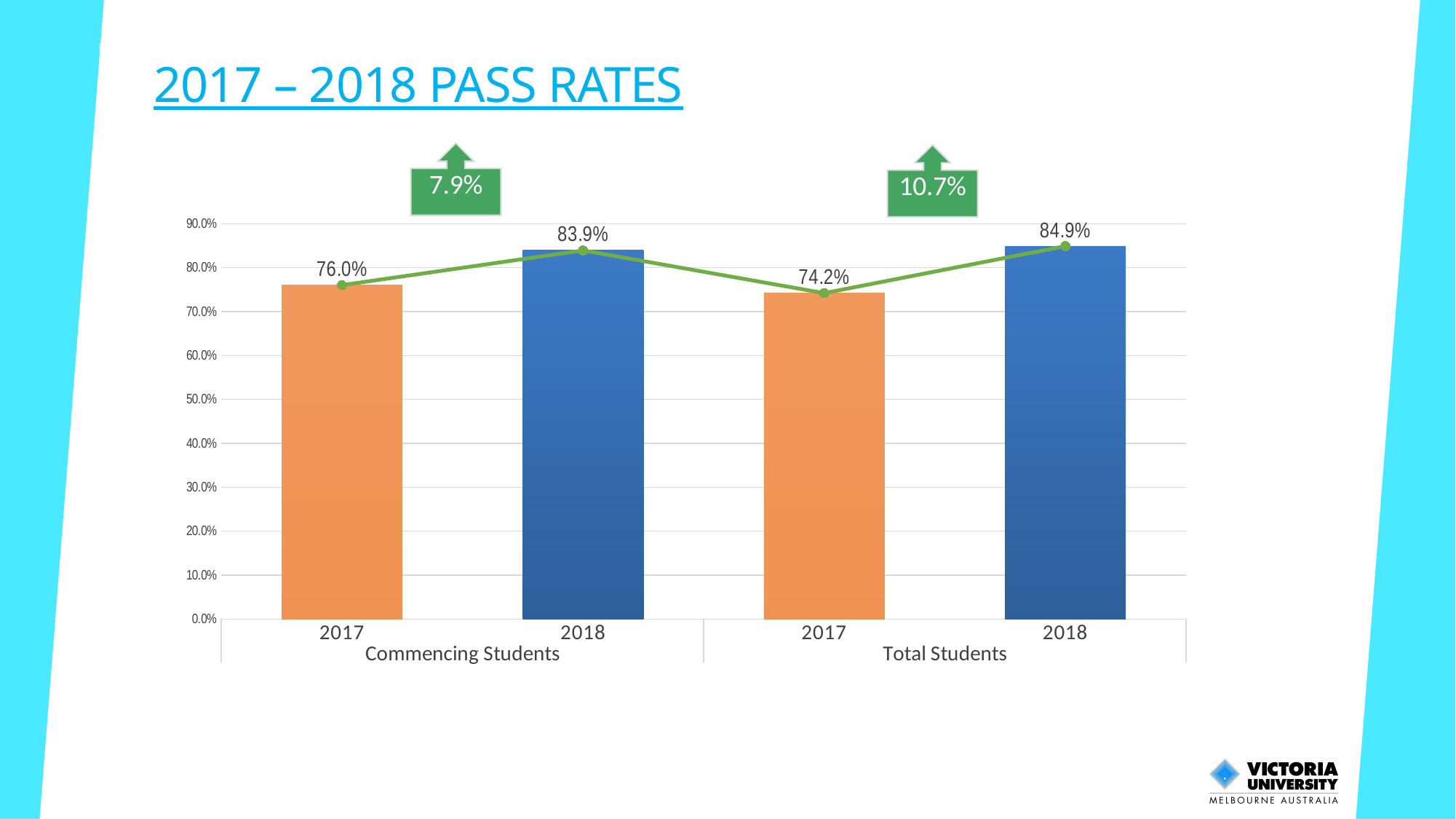
What was the pass rate for Total Students in 2017? 74.2% Which bar shows the lowest pass rate? Total Students 2017 How many bars are plotted in the chart? 4 What was the pass rate for Total Students in 2018? 84.9% Which is higher: the 2018 pass rate for Commencing Students or the 2018 pass rate for Total Students? Total Students Which bar shows the highest pass rate? Total Students 2018 What type of chart is shown on the slide? Bar chart with a line overlay What was the pass rate for Commencing Students in 2017? 76.0% What is the title of the slide? 2017 – 2018 PASS RATES By how many percentage points did the Total Students pass rate change from 2017 to 2018? 10.7% By how many percentage points did the Commencing Students pass rate change from 2017 to 2018? 7.9% What was the pass rate for Commencing Students in 2018? 83.9%